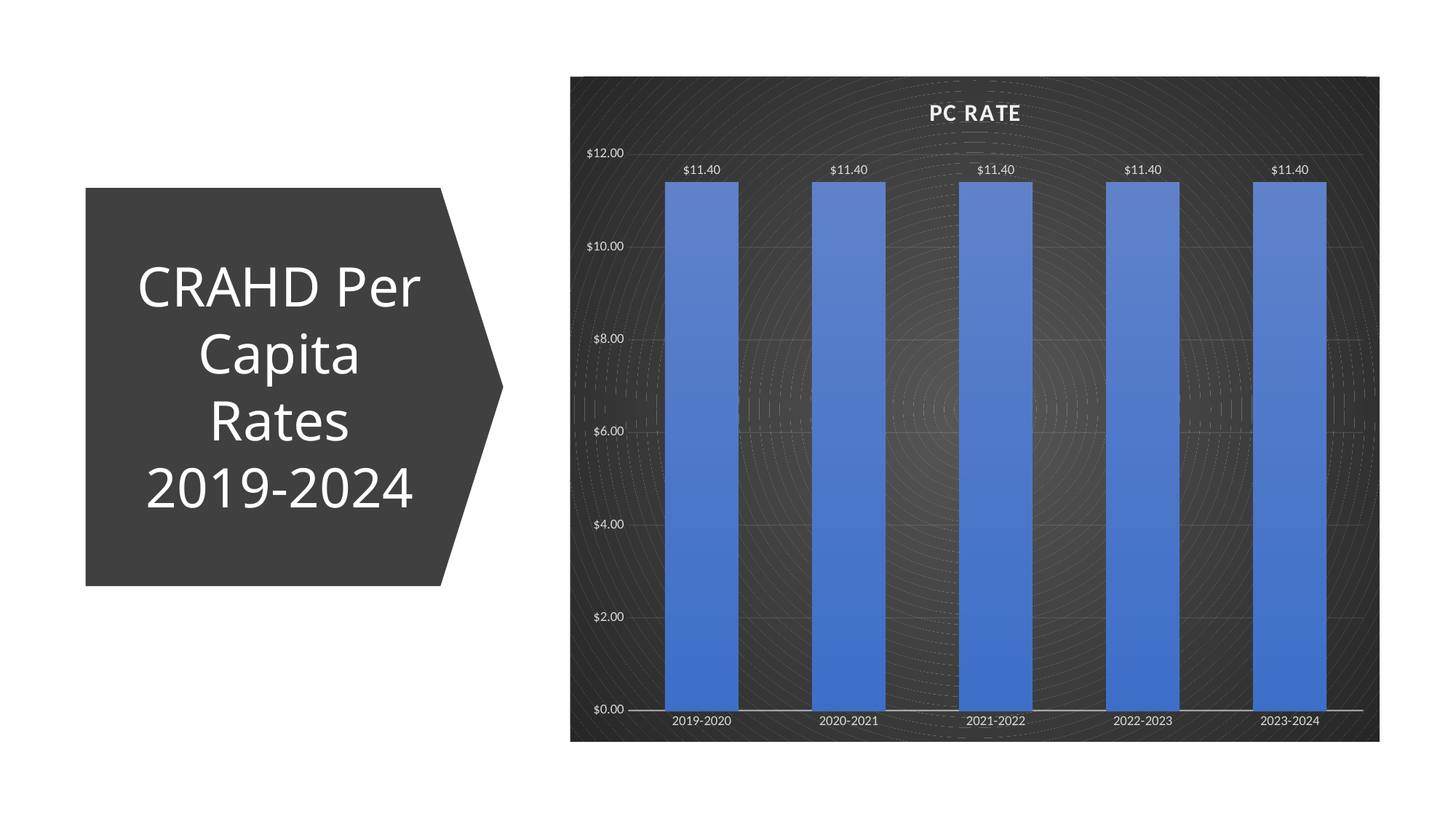
What is the PC Rate for 2021-2022? $11.40 What is the PC Rate for 2023-2024? $11.40 Is the PC Rate for 2022-2023 greater or less than $12.00? less Do the PC Rate values rise, fall, or stay the same from 2019-2020 to 2023-2024? stay the same What is the PC Rate for 2022-2023? $11.40 What is the first fiscal year shown on the x axis? 2019-2020 What is the title of the chart? PC RATE What kind of chart is shown on the slide? bar chart What is the difference between the PC Rate for 2019-2020 and 2023-2024? $0.00 How many fiscal years are shown on the chart? 5 Is the PC Rate for 2020-2021 greater or less than $10.00? greater What is the PC Rate for 2019-2020? $11.40